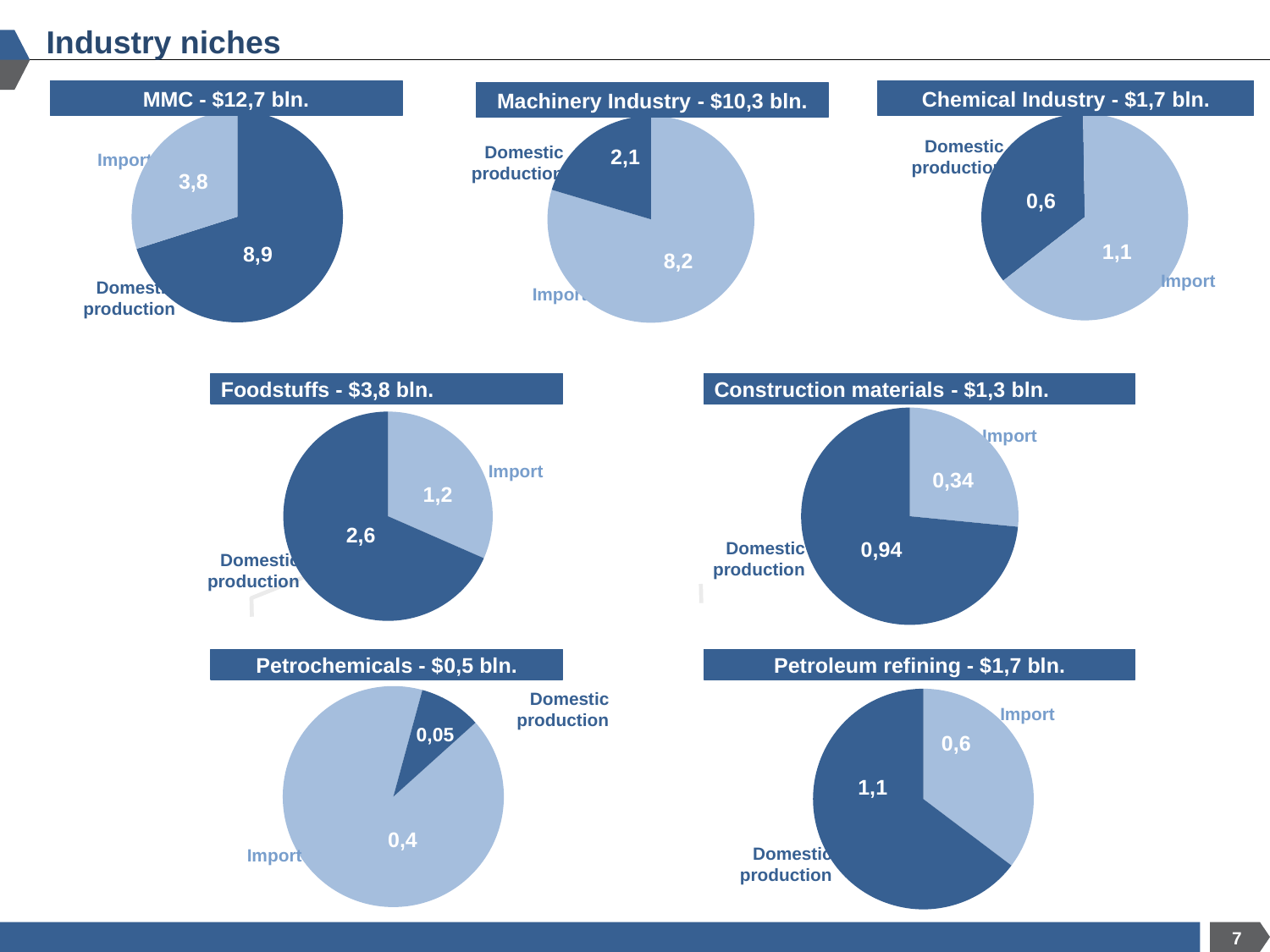
In the Foodstuffs pie chart, which slice is larger, Import or Domestic production? Domestic production In the Construction materials pie chart, what is the value for Import? 0,34 In the Petrochemicals pie chart, what is the value for Domestic production? 0,05 In the MMC pie chart, what is the value for Domestic production? 8,9 How many pie charts are shown on the slide? 7 In the Machinery Industry pie chart, which slice is the largest? Import In the Petrochemicals pie chart, what is the difference between Import and Domestic production? 0,35 In the Machinery Industry pie chart, what is the value for Import? 8,2 In the Chemical Industry pie chart, what is the value for Domestic production? 0,6 In the Petroleum refining pie chart, which slice is the smallest? Import What kind of chart is used for the Foodstuffs data? Pie chart In the MMC pie chart, what is the difference between Domestic production and Import? 5,1